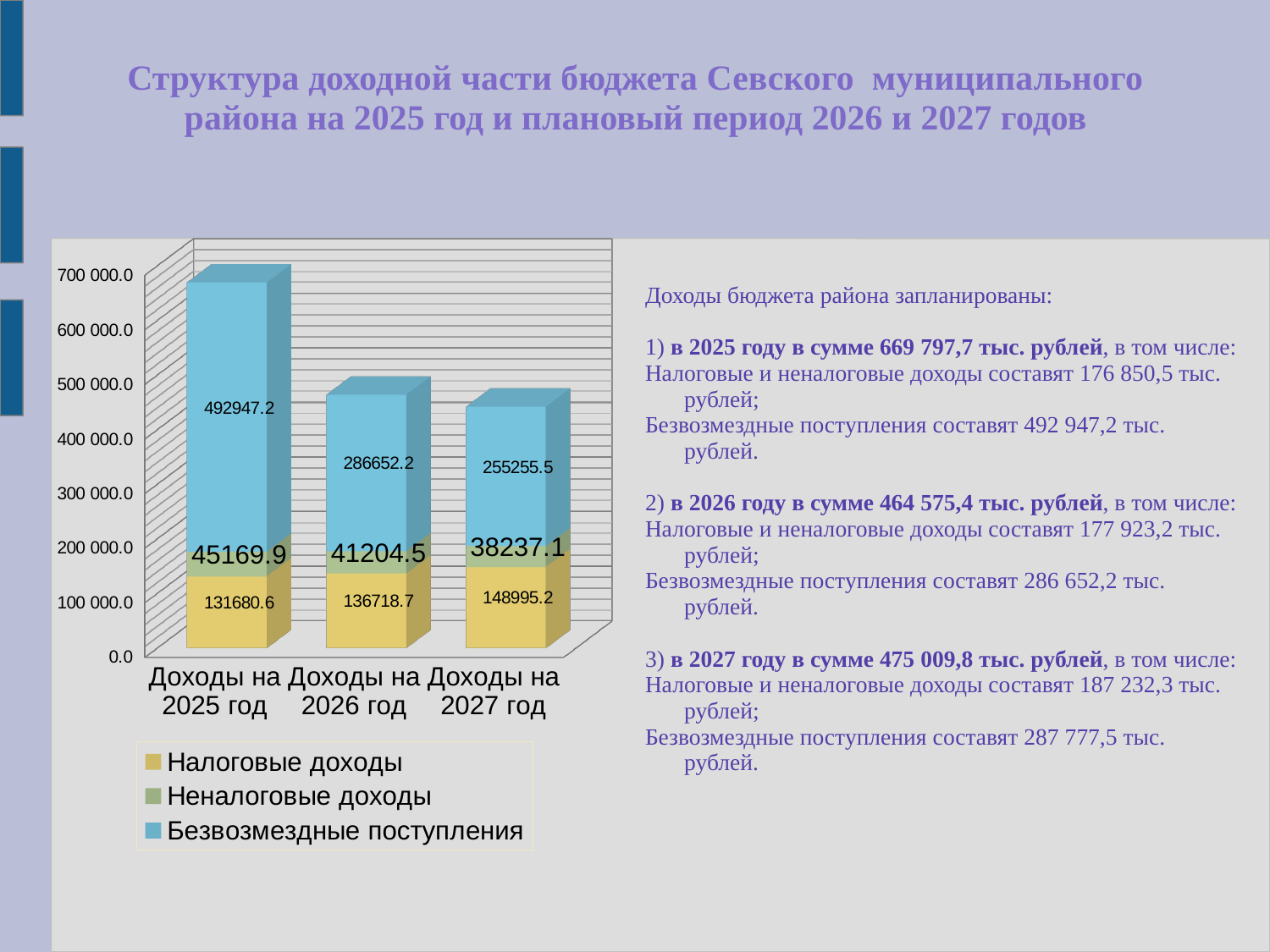
How many categories (years) are shown on the x axis of the chart? 3 Do the values of Безвозмездные поступления rise or fall from 2025 to 2027? Fall How many series does the chart legend list? 3 What is the value of Налоговые доходы for Доходы на 2027 год? 148995.2 What is the total of the stacked bar for Доходы на 2025 год? 669797.7 What type of chart is shown on the slide? Stacked bar chart What is the difference between Безвозмездные поступления for 2025 and for 2026? 206295.0 In which year is the value of Безвозмездные поступления the highest? Доходы на 2025 год What is the value of Неналоговые доходы for Доходы на 2026 год? 41204.5 Which is larger: Налоговые доходы for 2026 or Налоговые доходы for 2027? Налоговые доходы for 2027 In which year is the value of Неналоговые доходы the lowest? Доходы на 2027 год What is the value of Безвозмездные поступления for Доходы на 2025 год? 492947.2